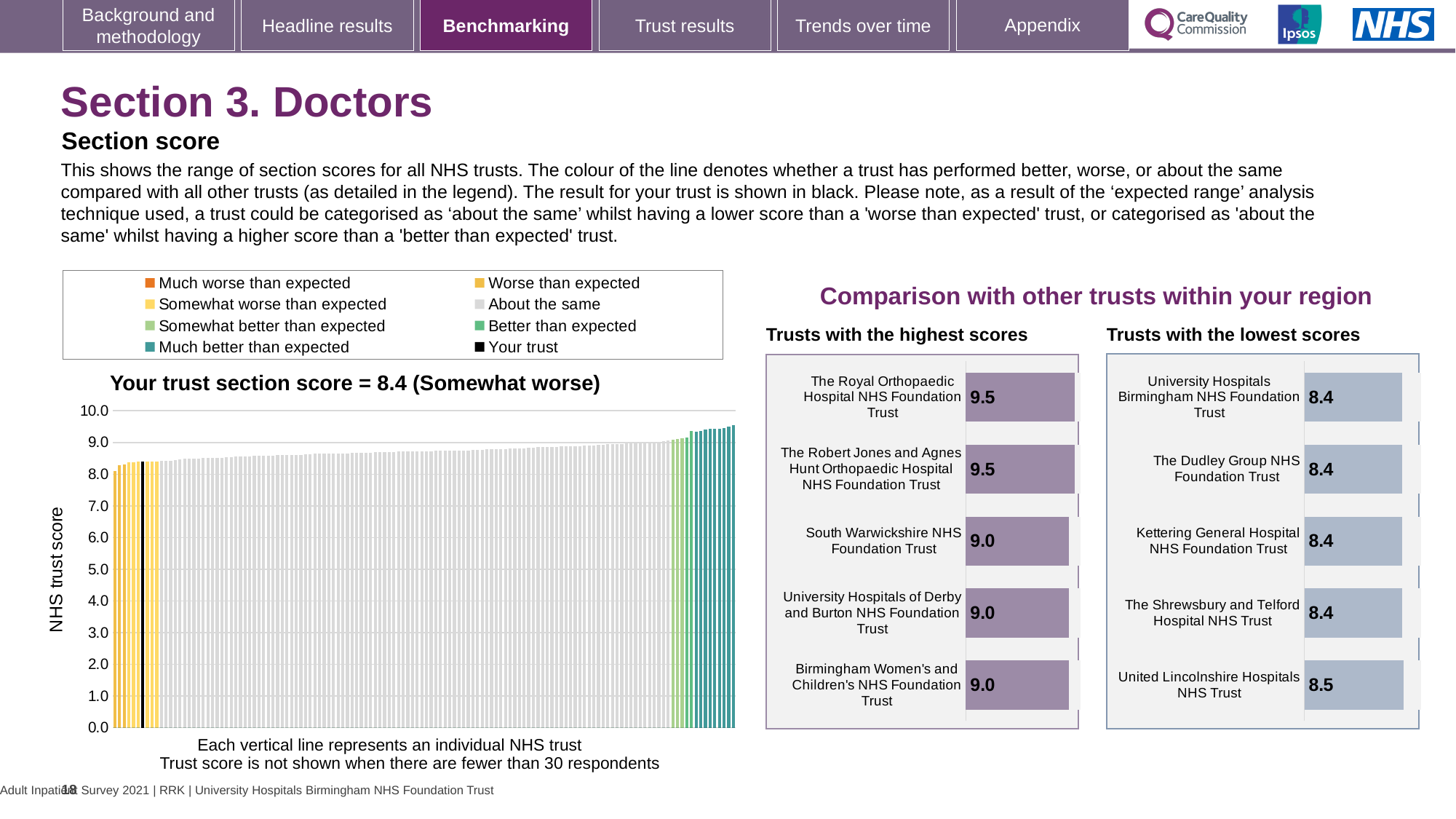
On the 'Your trust section score' chart, what is the section score for your trust? 8.4 On the 'Your trust section score' chart, is the value of the leftmost (lowest) bar greater or less than 9.0? less On the 'Trusts with the lowest scores' chart, what is the score for Kettering General Hospital NHS Foundation Trust? 8.4 On the 'Your trust section score' chart, is the value of the rightmost (highest) bar greater or less than 9.0? greater On the 'Trusts with the highest scores' chart, how many trusts are shown? 5 On the 'Trusts with the lowest scores' chart, which is larger: the score for United Lincolnshire Hospitals NHS Trust or the score for The Dudley Group NHS Foundation Trust? United Lincolnshire Hospitals NHS Trust On the 'Your trust section score' chart, what kind of chart is shown? bar chart How many entries does the legend above the 'Your trust section score' chart list? 8 On the 'Trusts with the lowest scores' chart, which trust has the highest score? United Lincolnshire Hospitals NHS Trust On the 'Trusts with the highest scores' chart, what is the score for South Warwickshire NHS Foundation Trust? 9.0 On the 'Trusts with the highest scores' chart, what is the difference between the score for The Royal Orthopaedic Hospital NHS Foundation Trust and the score for Birmingham Women's and Children's NHS Foundation Trust? 0.5 On the 'Your trust section score' chart, do the bars rise or fall from left to right along the x axis? rise